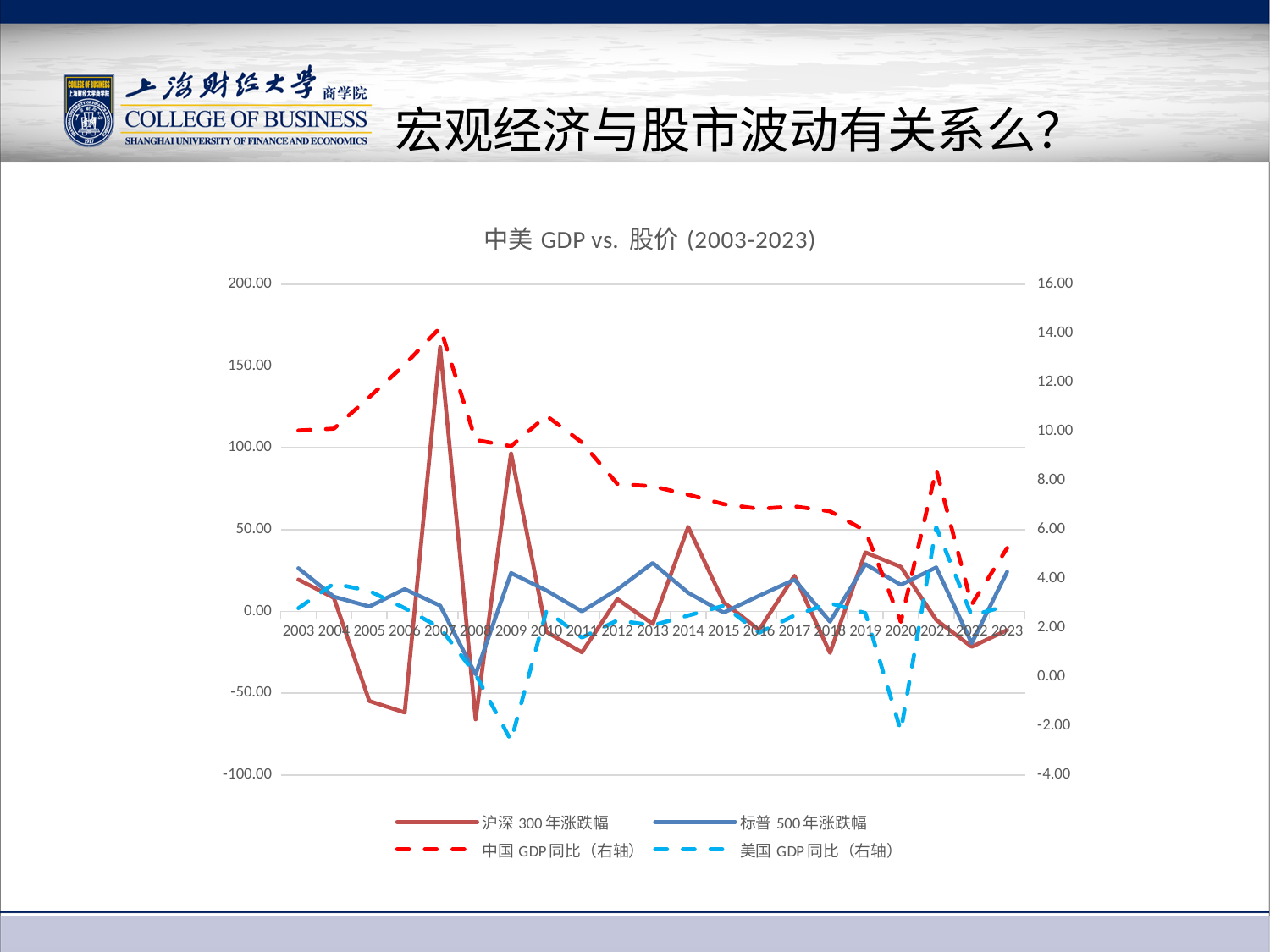
How many series does the legend list? 4 In 2009, which is larger: 沪深 300 年涨跌幅 or 标普 500 年涨跌幅? 沪深 300 年涨跌幅 Is the value for 美国 GDP 同比（右轴） in 2020 greater or less than 0.00 on the right axis? less Which series is drawn as a red dashed line? 中国 GDP 同比（右轴） What kind of chart is shown on the slide? line chart What is the title of the chart? 中美 GDP vs. 股价 (2003-2023) Is the value for 中国 GDP 同比（右轴） in 2007 greater or less than 12.00 on the right axis? greater Is the value for 沪深 300 年涨跌幅 in 2008 greater or less than -50.00? less How many years are plotted along the x axis? 21 In which year does 沪深 300 年涨跌幅 reach its highest value? 2007 In which year does 中国 GDP 同比（右轴） reach its highest value? 2007